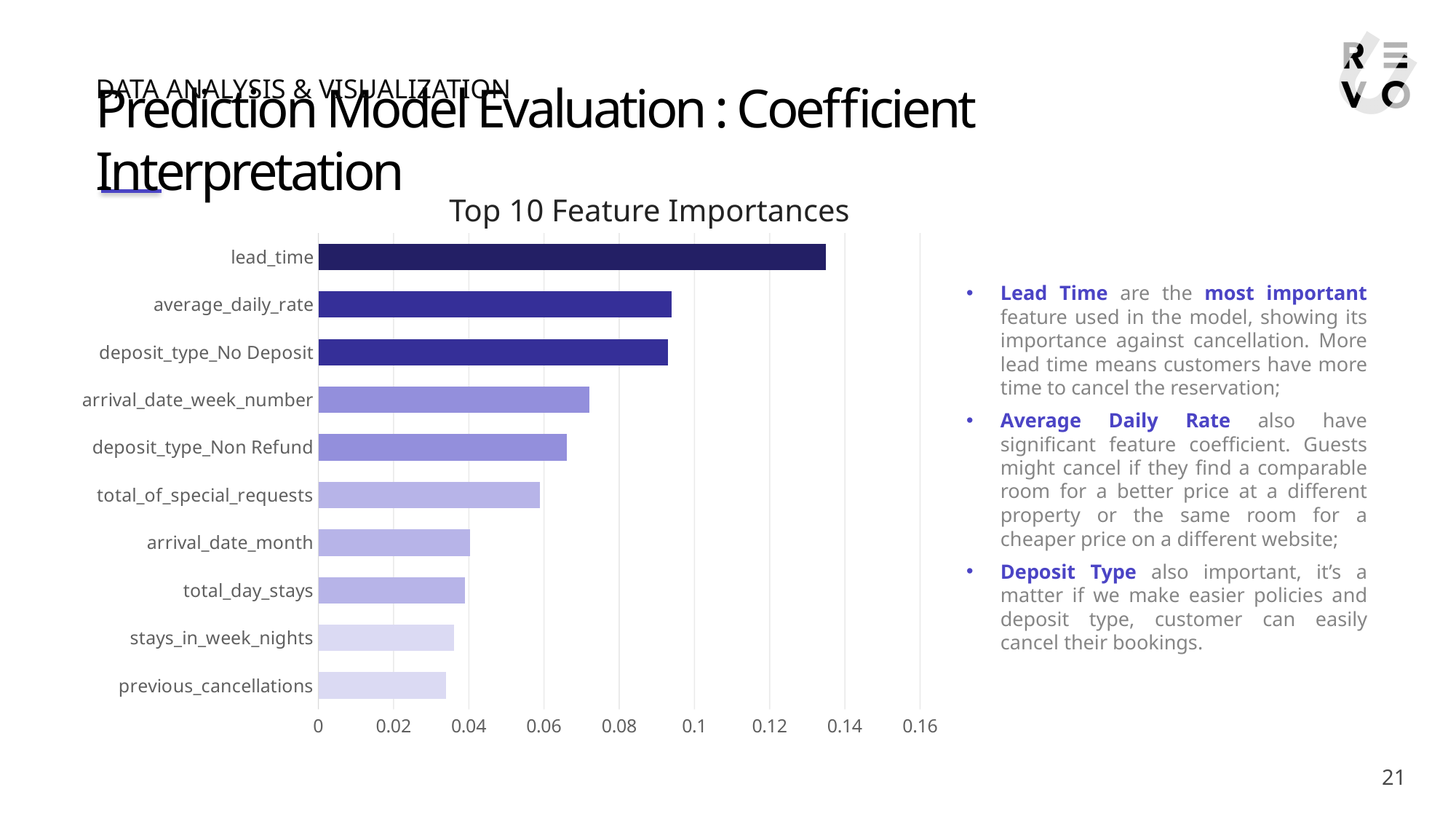
What is the title of the chart? Top 10 Feature Importances Is the value for arrival_date_week_number greater or less than 0.06? greater What kind of chart is shown on the slide? bar chart Is the value for average_daily_rate greater or less than 0.08? greater Is the value for stays_in_week_nights greater or less than 0.04? less Which feature has the highest importance in the chart? lead_time How many features are plotted in the chart? 10 Which has a larger value, lead_time or average_daily_rate? lead_time Which feature has the lowest importance in the chart? previous_cancellations Which has a larger value, arrival_date_week_number or deposit_type_Non Refund? arrival_date_week_number